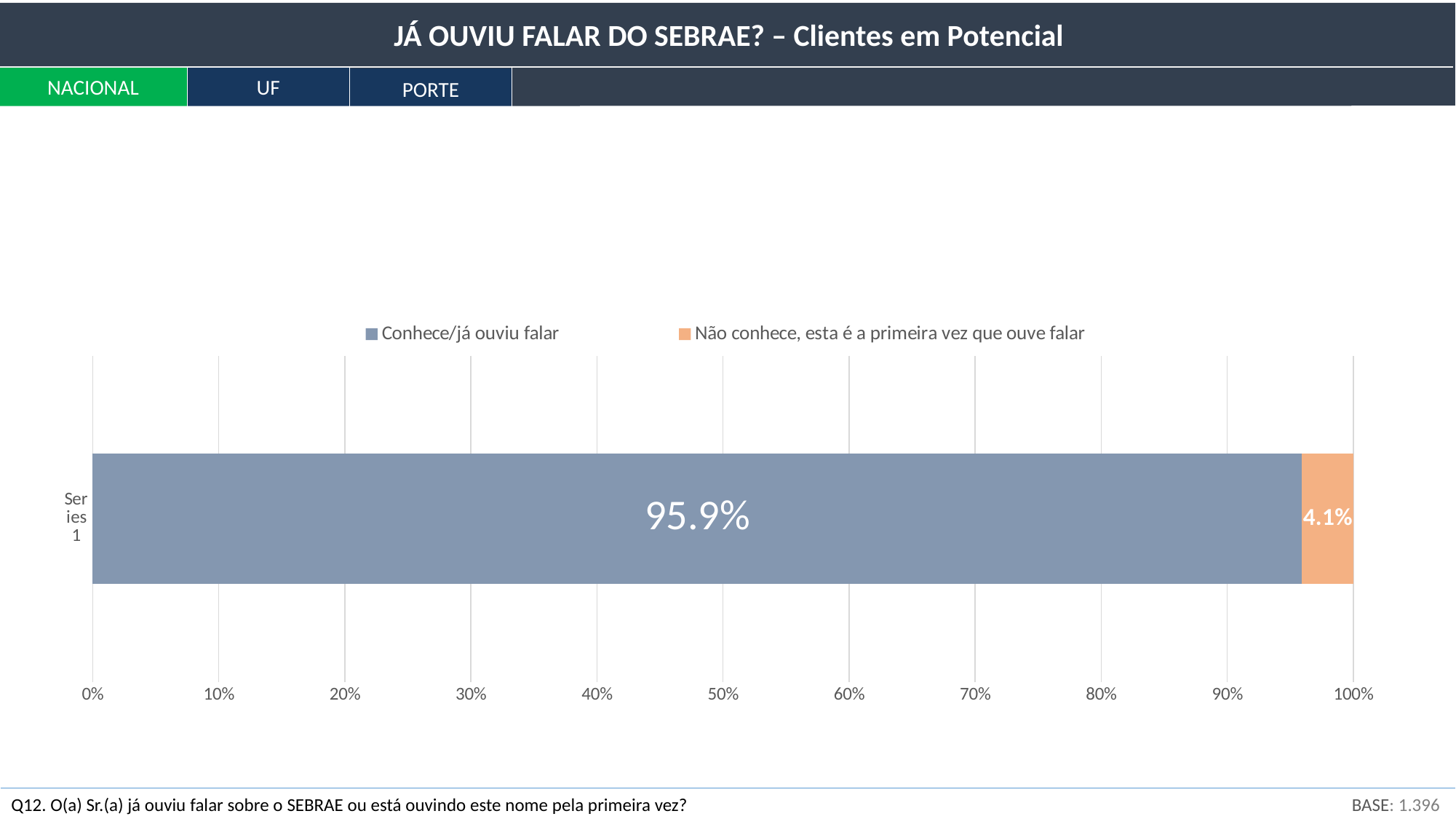
What is the difference in percentage points between "Conhece/já ouviu falar" and "Não conhece, esta é a primeira vez que ouve falar"? 91.8 percentage points Which response has the larger share: "Conhece/já ouviu falar" or "Não conhece, esta é a primeira vez que ouve falar"? Conhece/já ouviu falar What colour is the segment for "Não conhece, esta é a primeira vez que ouve falar"? Orange How many series does the legend list? 2 Is the value for "Conhece/já ouviu falar" greater or less than 90%? greater What percentage of respondents answered "Conhece/já ouviu falar"? 95.9% What is the total of the two segments in the stacked bar? 100% What percentage of respondents answered "Não conhece, esta é a primeira vez que ouve falar"? 4.1% Is the value for "Não conhece, esta é a primeira vez que ouve falar" greater or less than 10%? less What kind of chart is shown on the slide? Stacked horizontal bar chart Which segment has the smallest value in the bar? Não conhece, esta é a primeira vez que ouve falar What is the base (number of respondents) shown on the slide? 1.396